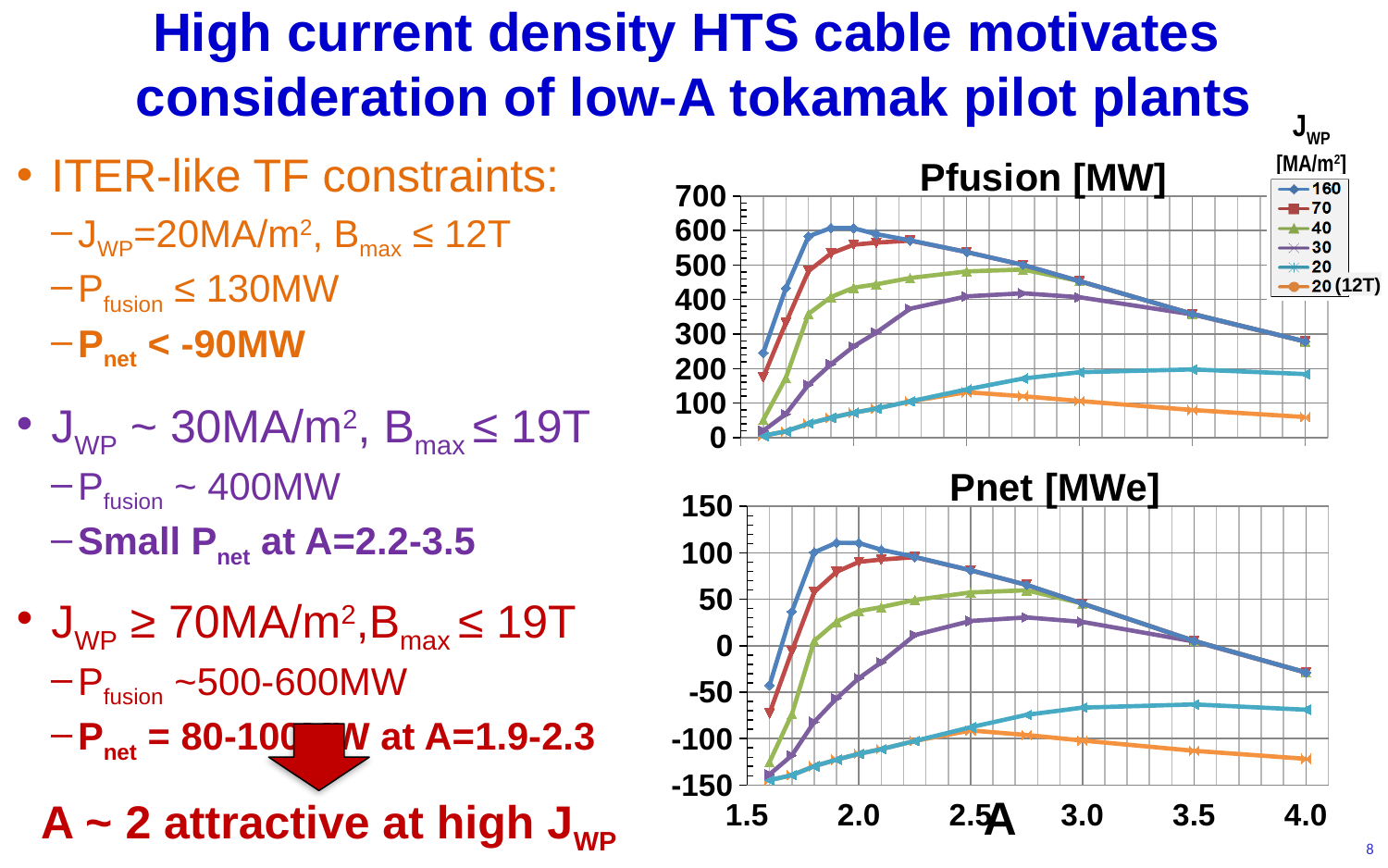
In the Pfusion [MW] chart, which series has the lowest value at A = 4.0? 20 (12T) In the Pfusion [MW] chart, which series reaches the highest peak value? 160 In the Pnet [MWe] chart, is the peak value of the 160 series greater or less than 100? greater In the Pnet [MWe] chart, does the 20 (12T) series rise or fall from A = 2.5 to A = 4.0? fall In the Pfusion [MW] chart, is the value of the 20 (12T) series at A = 4.0 greater or less than 100? less In the Pnet [MWe] chart, at A = 4.0, which series has the larger value: 160 or 20 (12T)? 160 What kind of chart is the Pfusion [MW] chart? line chart What is the title of the legend shared by the two charts? JWP [MA/m²] What is the label of the x axis on the Pnet [MWe] chart? A In the Pfusion [MW] chart, is the peak value of the 160 series greater or less than 500? greater How many series does the legend list for the charts? 6